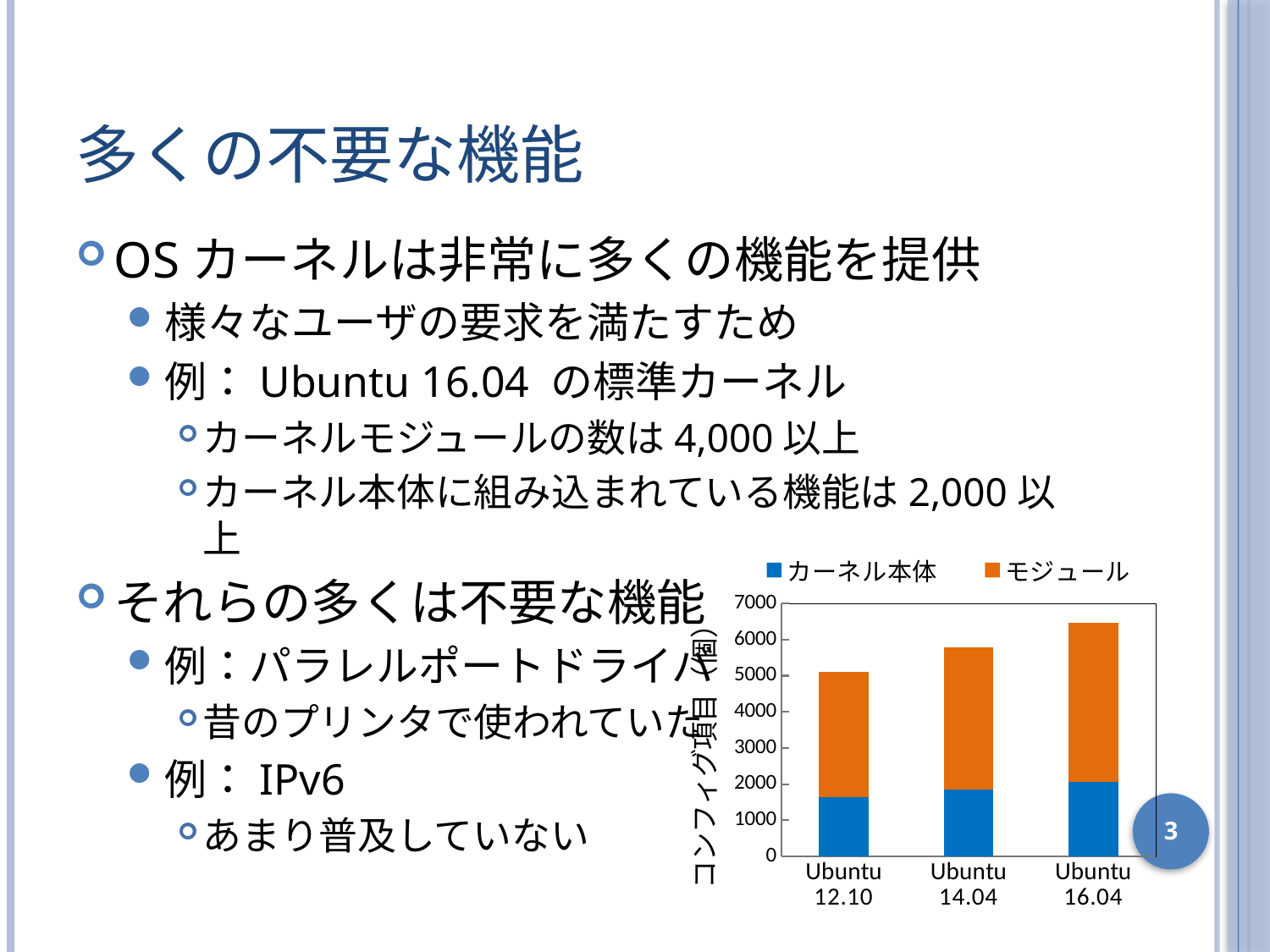
How many series does the chart's legend list? 2 Which Ubuntu version has the lowest total number of config items in the chart? Ubuntu 12.10 For Ubuntu 16.04, which series is larger: カーネル本体 or モジュール? モジュール Is the カーネル本体 value for Ubuntu 12.10 greater or less than 2000? less Is the total bar height for Ubuntu 16.04 greater or less than 6000? greater Is the total bar height for Ubuntu 14.04 greater or less than 6000? less Do the total bar heights rise or fall from Ubuntu 12.10 to Ubuntu 16.04? Rise What is the label on the chart's vertical axis? コンフィグ項目 (個) Which Ubuntu version has the highest total number of config items in the chart? Ubuntu 16.04 What kind of chart is shown on the slide? Stacked bar chart How many Ubuntu versions are shown on the x axis of the chart? 3 What are the two legend entries of the chart? カーネル本体 and モジュール